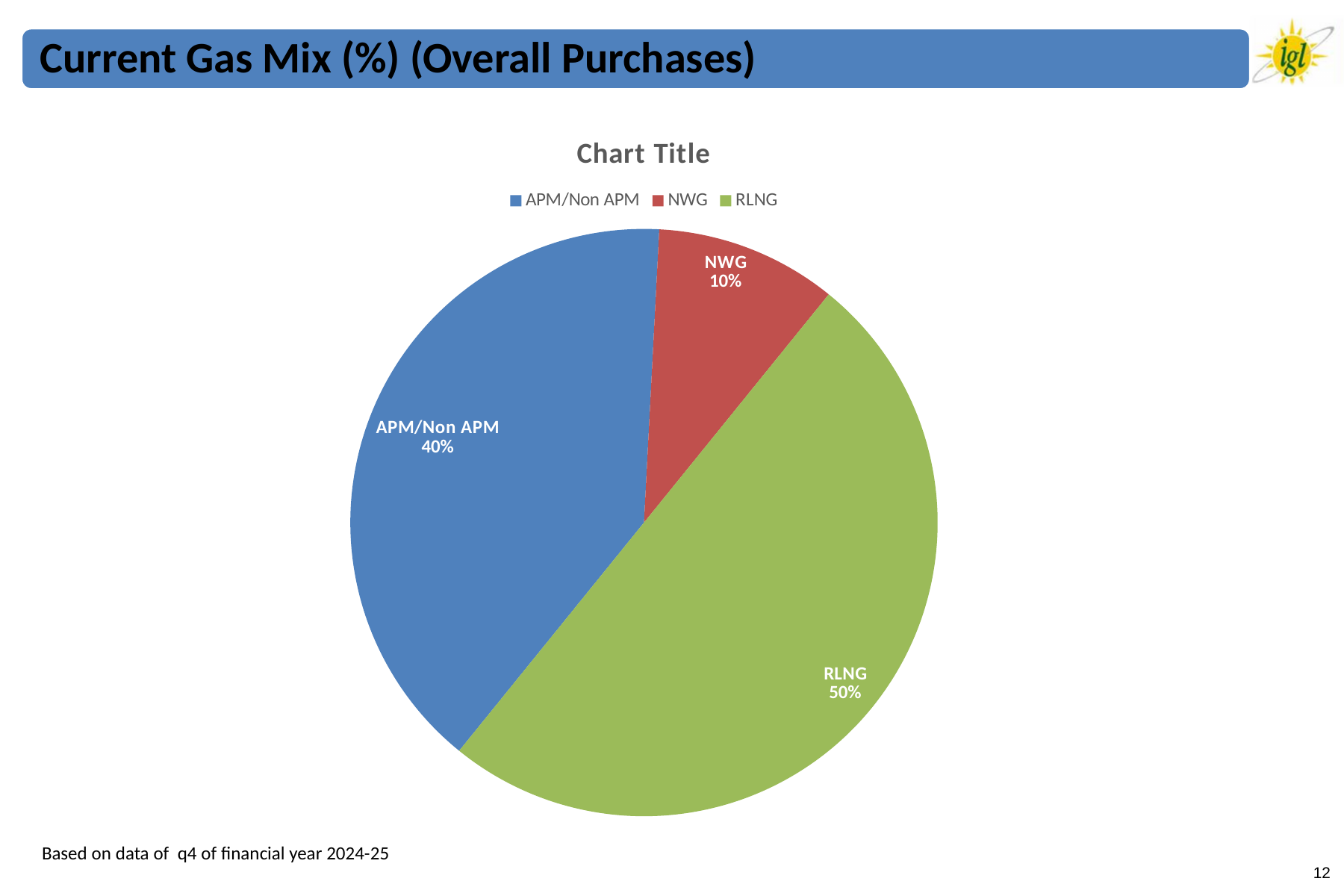
What share of the pie does RLNG account for? 50% What is the difference in percentage points between the RLNG and APM/Non APM slices? 10 Which category has the smallest slice of the pie? NWG What share of the pie does NWG account for? 10% What kind of chart is shown on the slide? Pie chart What colour is the RLNG slice? Green What is the title shown above the chart? Chart Title Which category has the largest slice of the pie? RLNG How many slices does the pie chart have? 3 What is the difference in percentage points between the APM/Non APM and NWG slices? 30 Which is larger, the APM/Non APM slice or the NWG slice? APM/Non APM What share of the pie does APM/Non APM account for? 40%